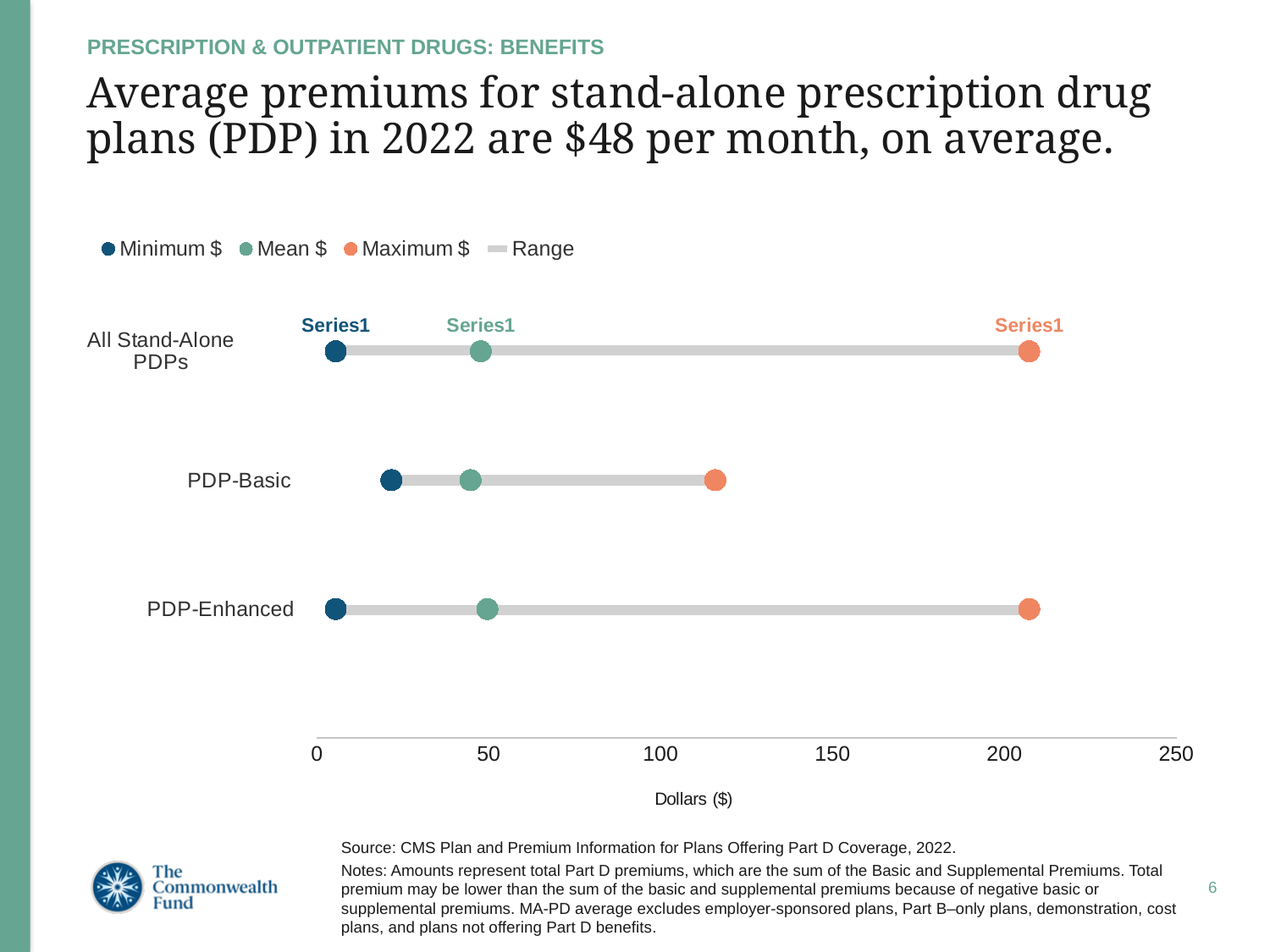
What is the label on the horizontal axis of the chart? Dollars ($) Is the Maximum $ value for All Stand-Alone PDPs greater or less than 100? greater Which has the larger Maximum $ value, PDP-Basic or PDP-Enhanced? PDP-Enhanced Which legend entry is shown in orange? Maximum $ Is the Maximum $ value for PDP-Enhanced greater or less than 150? greater Is the Minimum $ value for PDP-Basic greater or less than 50? less How many entries does the chart legend list? 4 Which category has the lowest Maximum $ value? PDP-Basic Which has the larger Minimum $ value, All Stand-Alone PDPs or PDP-Basic? PDP-Basic How many plan categories are shown on the chart? 3 Which category has the highest Minimum $ value? PDP-Basic